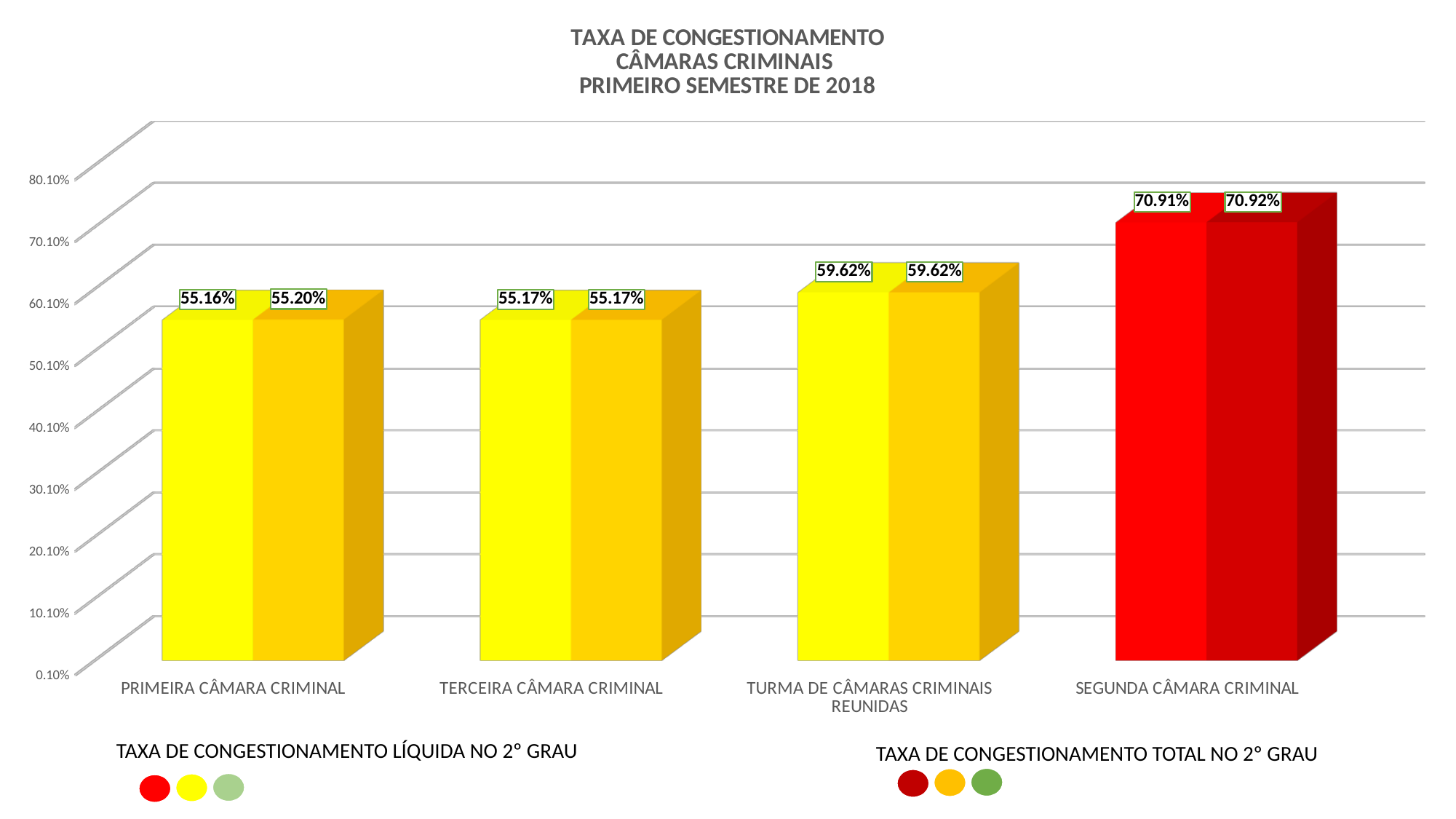
What is the TAXA DE CONGESTIONAMENTO LÍQUIDA NO 2º GRAU for TURMA DE CÂMARAS CRIMINAIS REUNIDAS? 59.62% What is the TAXA DE CONGESTIONAMENTO LÍQUIDA NO 2º GRAU for PRIMEIRA CÂMARA CRIMINAL? 55.16% What kind of chart is shown on the slide? Bar chart Which category has the highest TAXA DE CONGESTIONAMENTO LÍQUIDA NO 2º GRAU? SEGUNDA CÂMARA CRIMINAL Which category has the lowest TAXA DE CONGESTIONAMENTO TOTAL NO 2º GRAU? TERCEIRA CÂMARA CRIMINAL What is the difference between the TAXA DE CONGESTIONAMENTO LÍQUIDA NO 2º GRAU for SEGUNDA CÂMARA CRIMINAL and for TERCEIRA CÂMARA CRIMINAL? 15.74% Which is larger: the TAXA DE CONGESTIONAMENTO TOTAL NO 2º GRAU for TURMA DE CÂMARAS CRIMINAIS REUNIDAS or for PRIMEIRA CÂMARA CRIMINAL? TURMA DE CÂMARAS CRIMINAIS REUNIDAS What is the TAXA DE CONGESTIONAMENTO TOTAL NO 2º GRAU for SEGUNDA CÂMARA CRIMINAL? 70.92% How many series does the legend list? 2 What is the title of the chart? TAXA DE CONGESTIONAMENTO CÂMARAS CRIMINAIS PRIMEIRO SEMESTRE DE 2018 What is the TAXA DE CONGESTIONAMENTO TOTAL NO 2º GRAU for PRIMEIRA CÂMARA CRIMINAL? 55.20% How many categories are shown on the x axis? 4